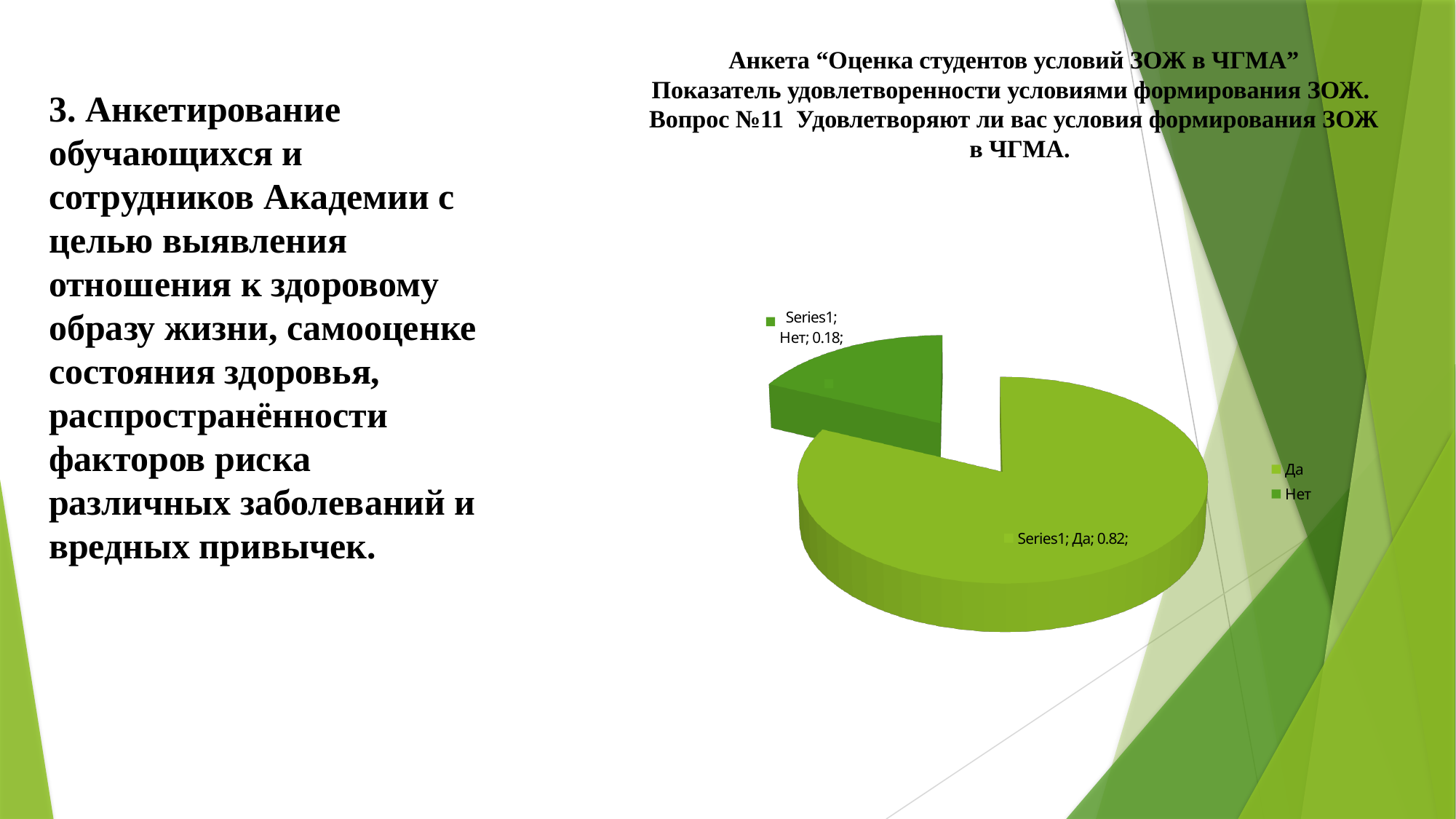
What kind of chart is shown on the slide? pie chart Which slice of the pie chart is the largest? Да What is the difference between the values for "Да" and "Нет" in the pie chart? 0.64 How many slices does the pie chart have? 2 What is the value for "Нет" in the pie chart? 0.18 What are the two legend entries of the pie chart? Да, Нет What is the value for "Да" in the pie chart? 0.82 Which is larger in the pie chart, "Да" or "Нет"? Да How many entries does the legend of the pie chart list? 2 What series name appears in the data labels of the pie chart? Series1 Which slice of the pie chart is the smallest? Нет